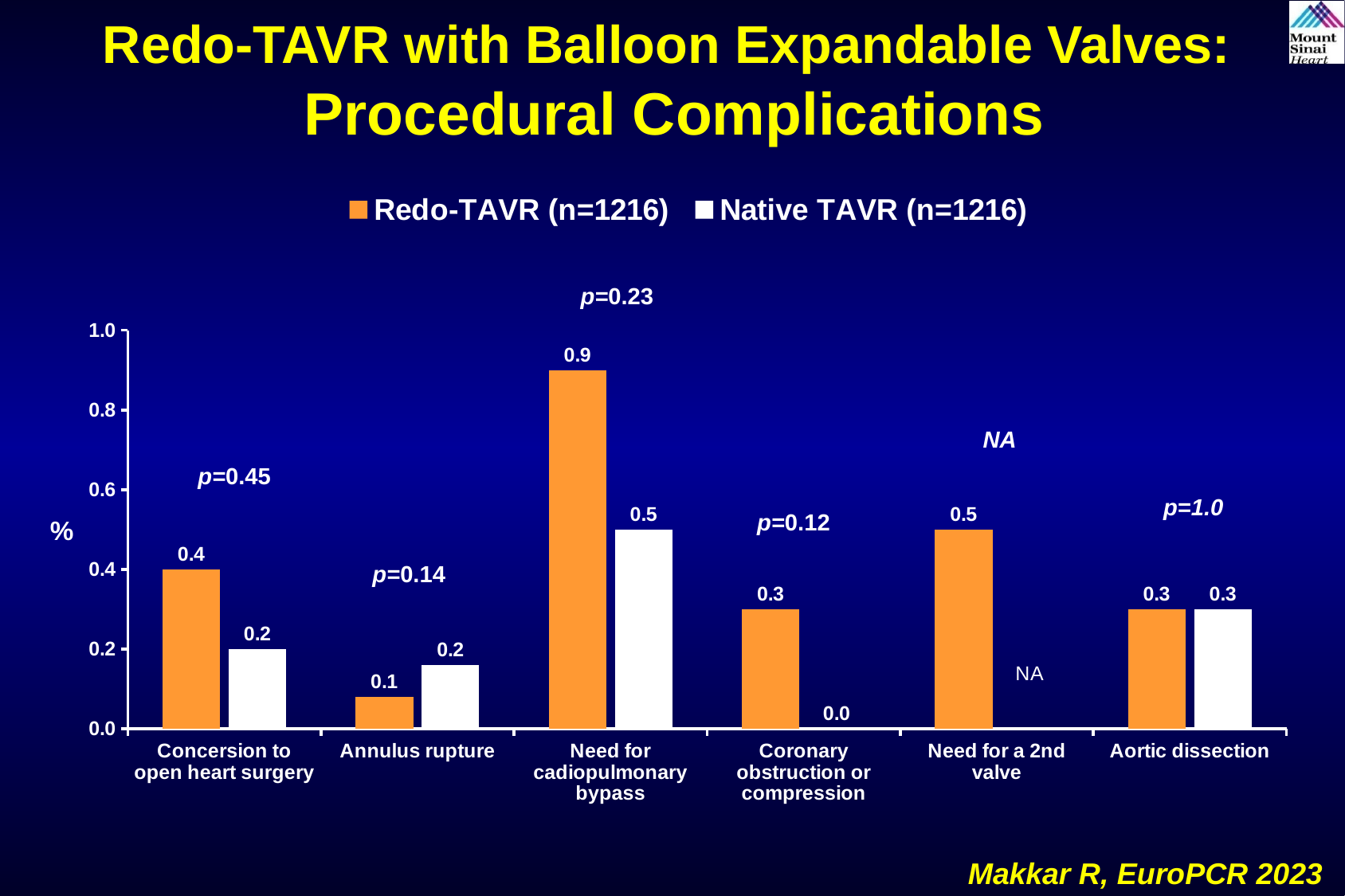
What is the Native TAVR value for Concersion to open heart surgery? 0.2 What is the Redo-TAVR value for Need for cadiopulmonary bypass? 0.9 How many series does the legend list? 2 What is the Redo-TAVR value for Annulus rupture? 0.1 Which category has the lowest Redo-TAVR value? Annulus rupture Which category has the highest Redo-TAVR value? Need for cadiopulmonary bypass What is the difference between the Redo-TAVR and Native TAVR values for Need for cadiopulmonary bypass? 0.4 What is the Native TAVR value for Coronary obstruction or compression? 0.0 What kind of chart is shown on the slide? Bar chart What p-value is shown above the Need for cadiopulmonary bypass bars? p=0.23 Which is larger for Concersion to open heart surgery, the Redo-TAVR value or the Native TAVR value? Redo-TAVR How many categories are shown on the x axis? 6